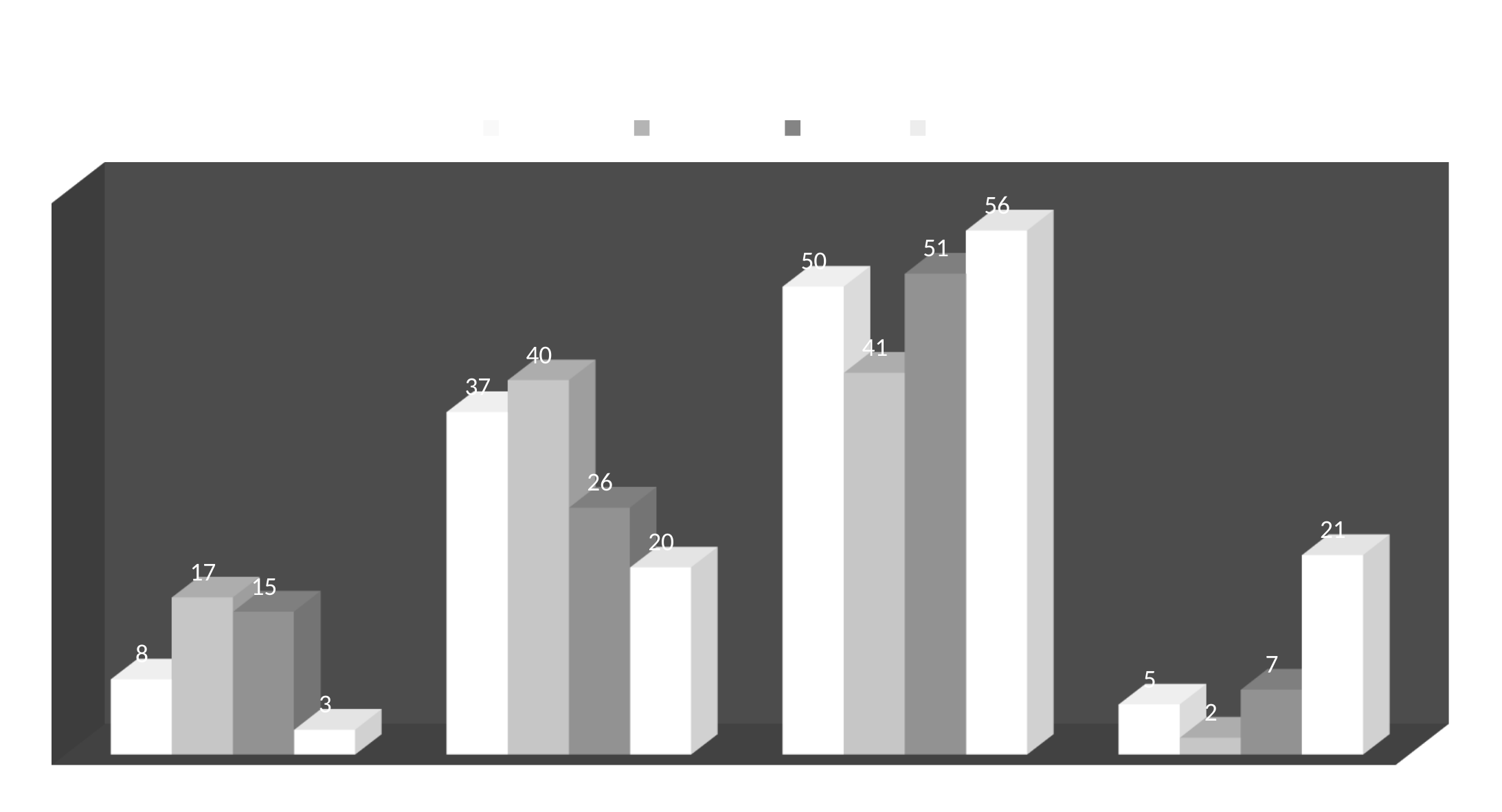
How many series does the legend list? 4 In the first group from the left, which is larger: the second bar or the third bar? the second bar (17) How many groups of bars are plotted along the x axis? 4 What is the value of the fourth bar in the first group from the left? 3 What is the value of the tallest bar in the third group from the left? 56 What is the difference between the second bar (40) and the third bar (26) in the second group from the left? 14 What kind of chart is shown on the slide? bar chart What is the value of the shortest bar in the fourth group from the left? 2 What is the value of the fourth bar in the fourth group from the left? 21 What is the difference between the fourth bar (56) and the second bar (41) in the third group from the left? 15 What is the value of the first bar in the second group from the left? 37 Which group of bars contains the highest value on the chart? the third group from the left